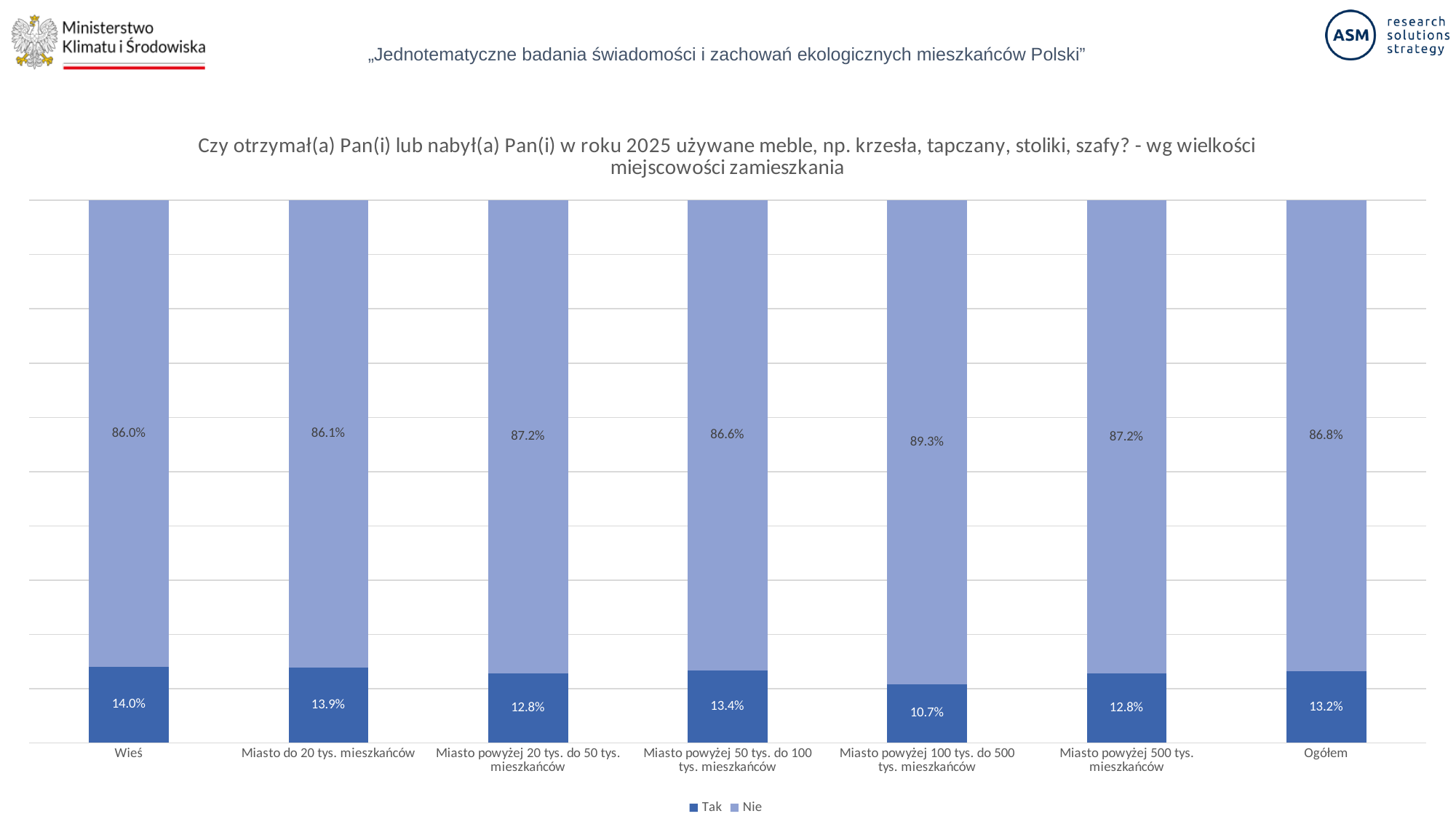
What is the total of the stacked bar for Miasto do 20 tys. mieszkańców? 100.0% Which series is shown in the darker blue colour at the bottom of each bar? Tak How many series does the legend list? 2 What is the "Nie" value for Miasto powyżej 100 tys. do 500 tys. mieszkańców? 89.3% Which is larger: the "Nie" value for Miasto powyżej 20 tys. do 50 tys. mieszkańców or the "Nie" value for Wieś? Miasto powyżej 20 tys. do 50 tys. mieszkańców What is the "Tak" value for Wieś? 14.0% Which category has the lowest "Tak" value? Miasto powyżej 100 tys. do 500 tys. mieszkańców What kind of chart is shown on the slide? Stacked bar chart What is the difference between the "Tak" value for Wieś and the "Tak" value for Miasto powyżej 100 tys. do 500 tys. mieszkańców? 3.3 percentage points What is the "Tak" value for Ogółem? 13.2% Which category has the highest "Tak" value? Wieś How many categories are shown on the x axis? 7